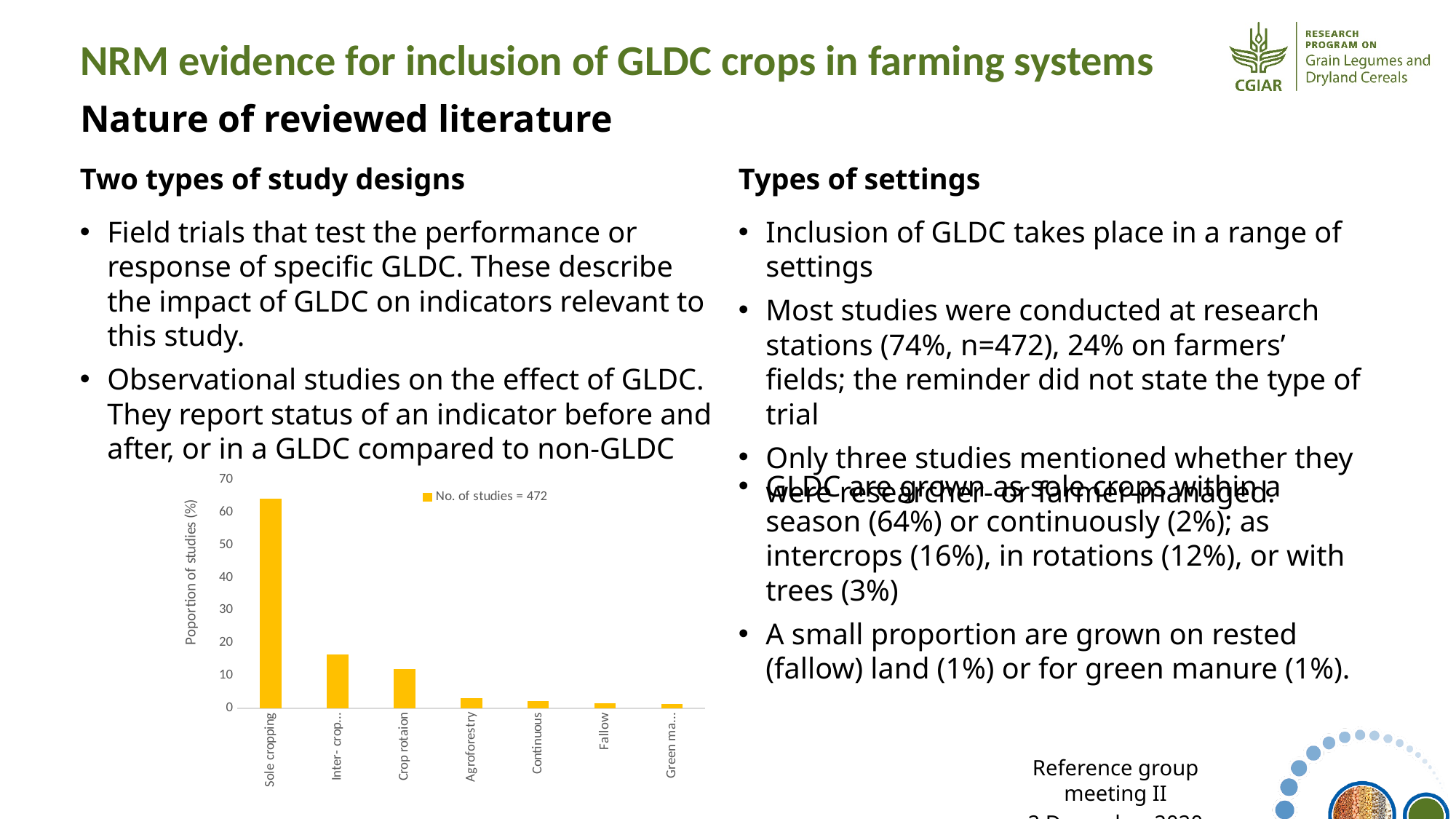
How many categories are plotted on the x axis of the chart? 7 Is the value for Inter- crop... greater or less than 10? greater What kind of chart is shown on the slide? Bar chart What text does the chart legend show? No. of studies = 472 Which category has the highest proportion of studies in the chart? Sole cropping Is the value for Sole cropping greater or less than 60? greater How many series does the chart legend list? 1 What is the label on the vertical axis of the chart? Poportion of studies (%) Which is larger in the chart, the value for Sole cropping or the value for Crop rotaion? Sole cropping Do the bar values rise or fall moving from left to right along the x axis? Fall Is the value for Agroforestry greater or less than 10? less